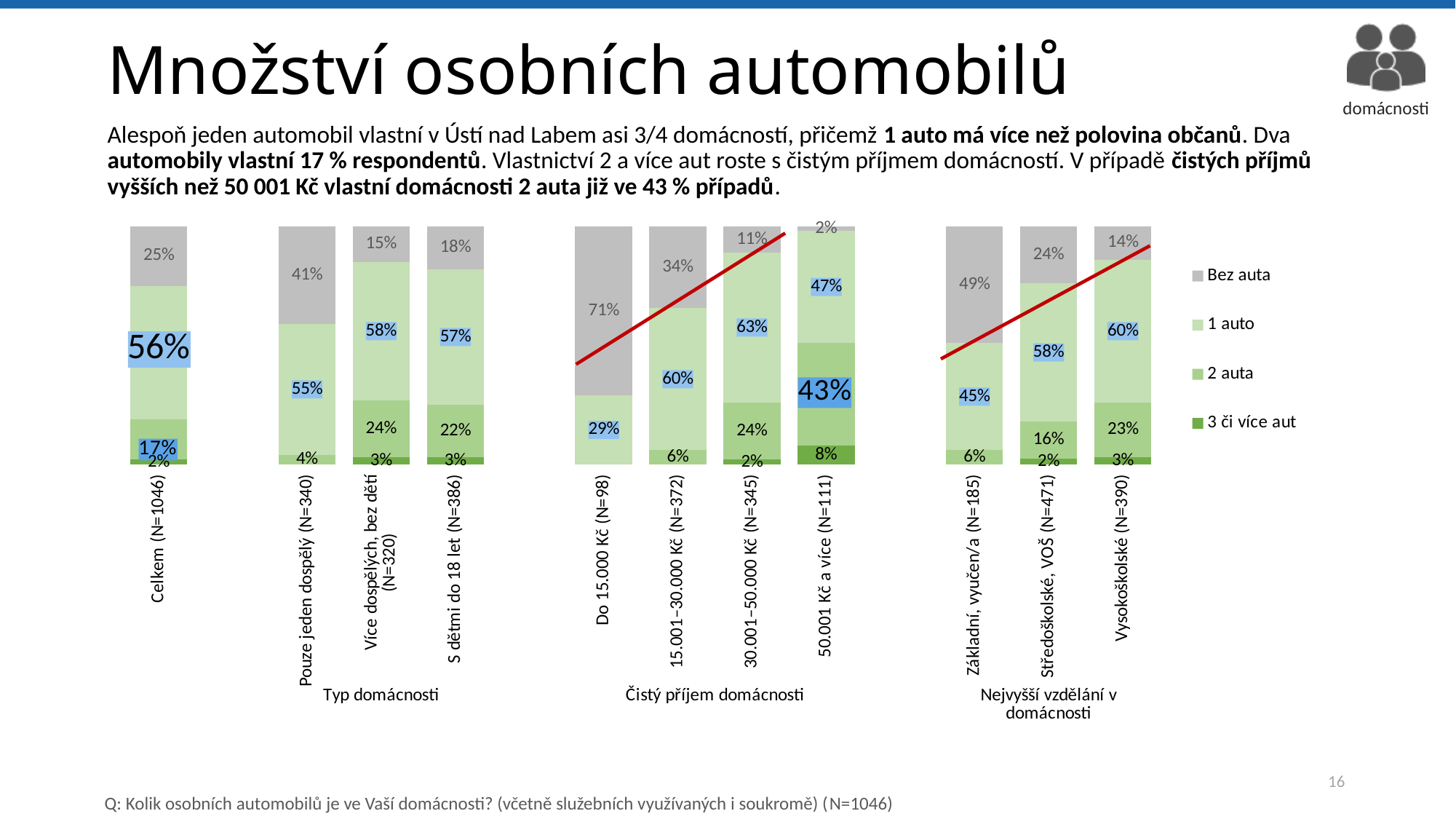
What is the '2 auta' value for the '50.001 Kč a více (N=111)' bar? 43% Which has a larger '1 auto' share: '30.001–50.000 Kč (N=345)' or '50.001 Kč a více (N=111)'? 30.001–50.000 Kč (N=345) What kind of chart is shown on the slide? Stacked bar chart What is the 'Bez auta' value for the 'Do 15.000 Kč (N=98)' bar? 71% How many bars are plotted on the chart? 11 Which category has the highest 'Bez auta' share? Do 15.000 Kč (N=98) What share of households in the 'Celkem (N=1046)' bar have '1 auto'? 56% What is the '3 či více aut' value for the 'Vysokoškolské (N=390)' bar? 3% What is the difference in the '2 auta' share between 'Vysokoškolské (N=390)' and 'Základní, vyučen/a (N=185)'? 17 percentage points Which category has the lowest 'Bez auta' share? 50.001 Kč a více (N=111) How many series does the legend list? 4 Does the 'Bez auta' share rise or fall as household net income increases across the 'Čistý příjem domácnosti' group? Fall